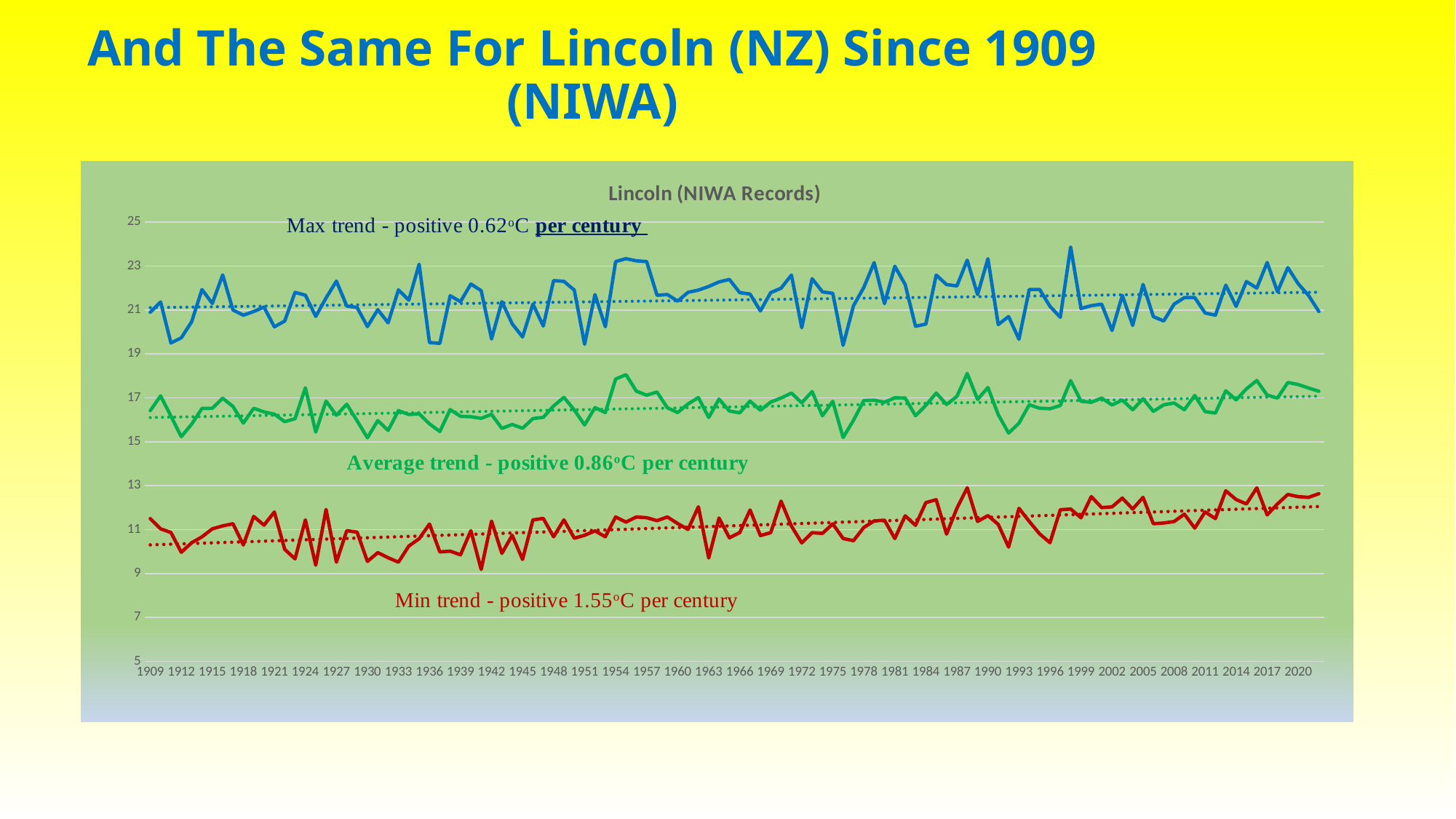
What is the average trend per century stated on the chart? positive 0.86°C per century What is the max trend per century stated on the chart? positive 0.62°C per century Which series is plotted higher on the chart, the blue line or the red line? the blue line What is the difference between the min trend and the max trend per century? 0.93°C Which of the three trends (max, average, min) has the largest value per century? Min trend How many solid data lines are plotted on the chart? 3 What is the min trend per century stated on the chart? positive 1.55°C per century What type of chart is shown on the slide? line chart Which of the three trends (max, average, min) has the smallest value per century? Max trend What is the title of the chart? Lincoln (NIWA Records) Does the dotted trend line for the red (min) series rise or fall from 1909 to 2020? rise Is the value of the red (min) line in 1909 greater or less than 13? less